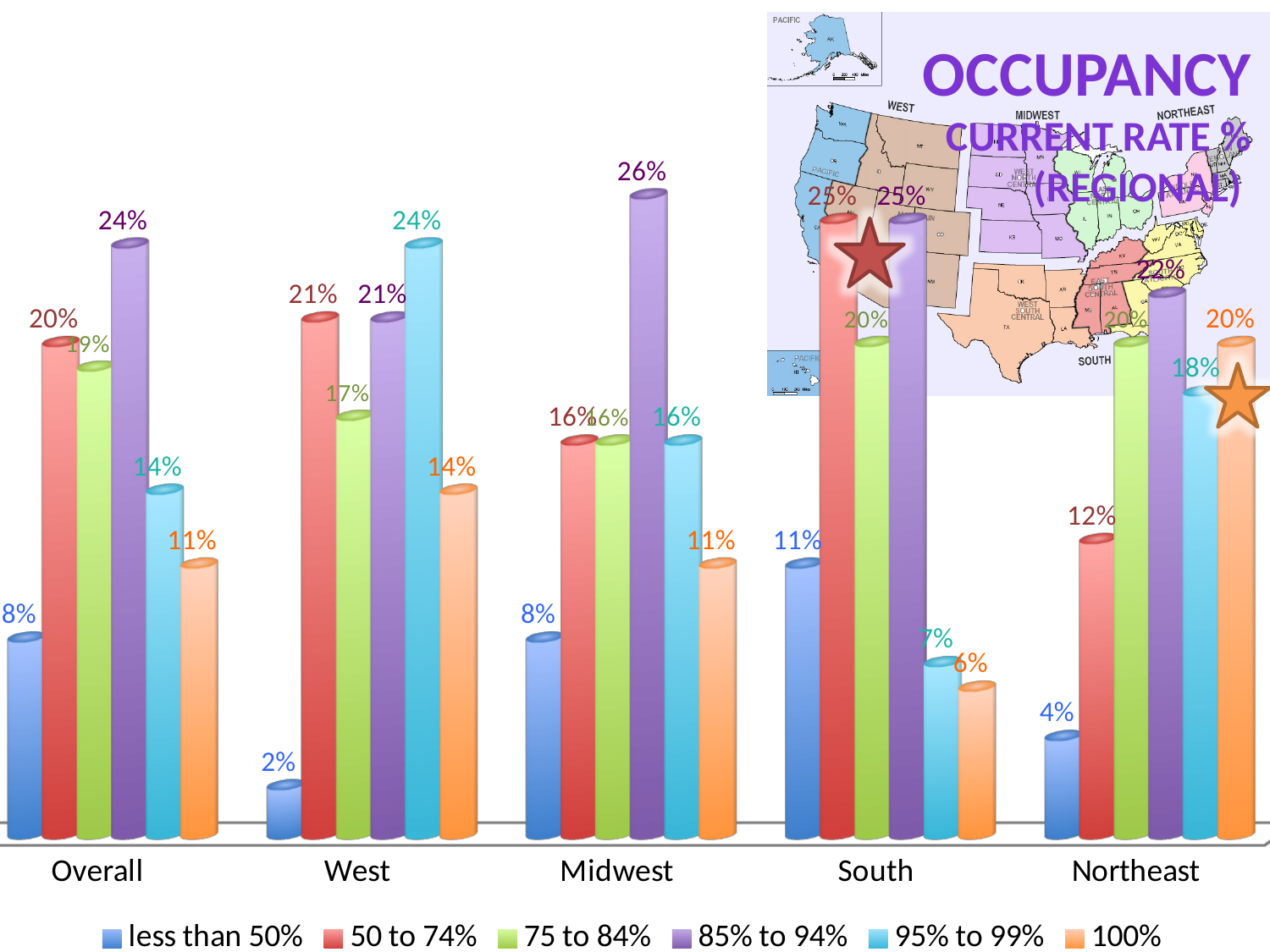
How many categories are shown on the x axis? 5 Which category has the lowest value for the less than 50% series? West What is the value for the less than 50% series in the West category? 2% How many series does the legend list? 6 In the West category, what is the difference between the 95% to 99% value and the 100% value? 10 percentage points What is the title of the chart? OCCUPANCY CURRENT RATE % (REGIONAL) What is the value for the 85% to 94% series in the Overall category? 24% Which category has the highest value for the 85% to 94% series? Midwest What kind of chart is shown on the slide? Bar chart In the Northeast category, which is larger: the 95% to 99% value or the less than 50% value? 95% to 99% What is the value for the 50 to 74% series in the Northeast category? 12% What is the value for the 85% to 94% series in the Midwest category? 26%